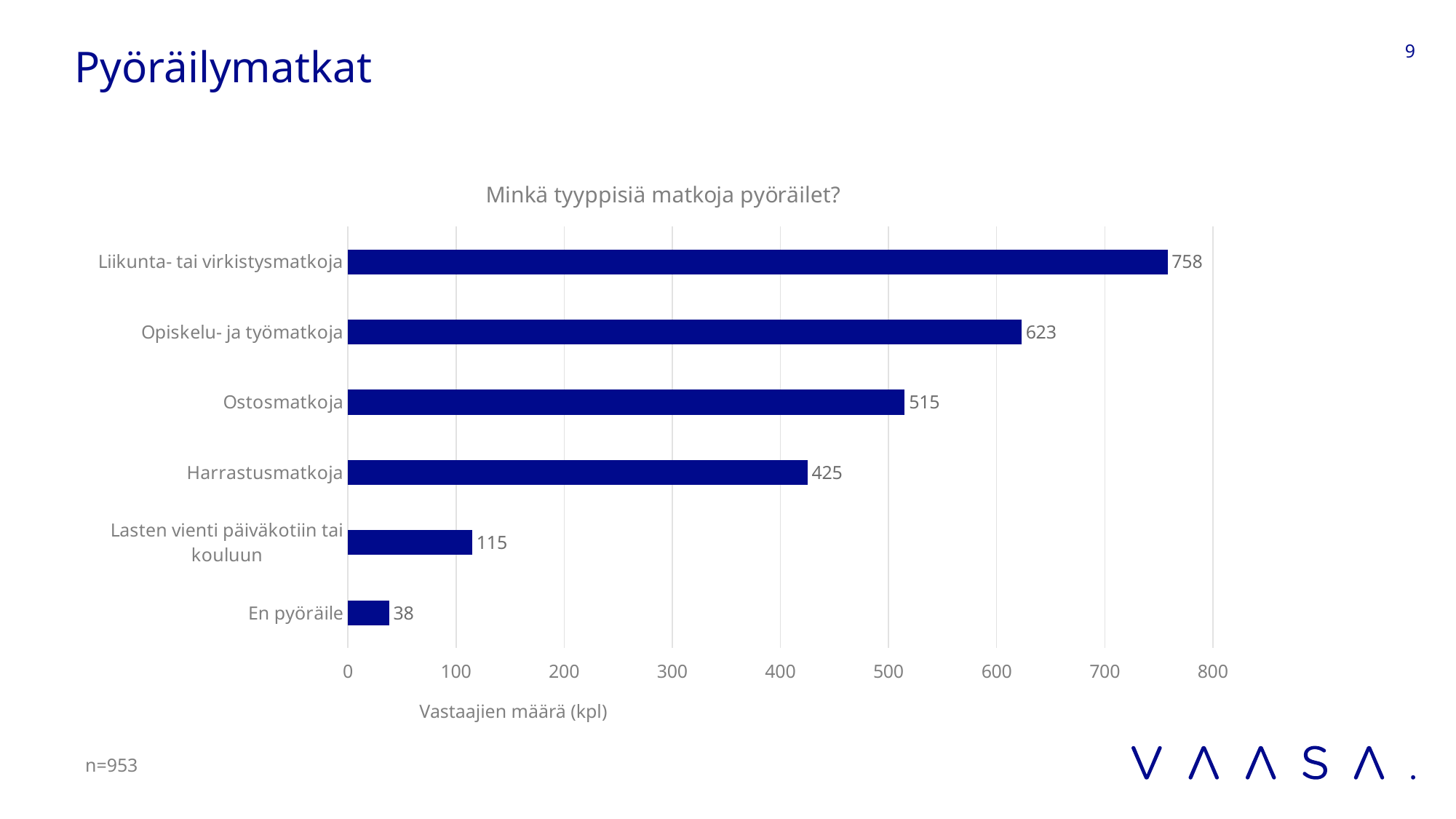
What is the difference between the values for Opiskelu- ja työmatkoja and Harrastusmatkoja? 198 What is the title of the chart? Minkä tyyppisiä matkoja pyöräilet? Is the value for Opiskelu- ja työmatkoja greater or less than 600? greater Which category has the highest value? Liikunta- tai virkistysmatkoja What is the value for Liikunta- tai virkistysmatkoja? 758 How many categories are shown in the chart? 6 Which category has the lowest value? En pyöräile What is the value for Ostosmatkoja? 515 Which is larger, the value for Ostosmatkoja or the value for Harrastusmatkoja? Ostosmatkoja What is the value for Lasten vienti päiväkotiin tai kouluun? 115 What is the label of the horizontal axis? Vastaajien määrä (kpl) What kind of chart is shown on the slide? bar chart